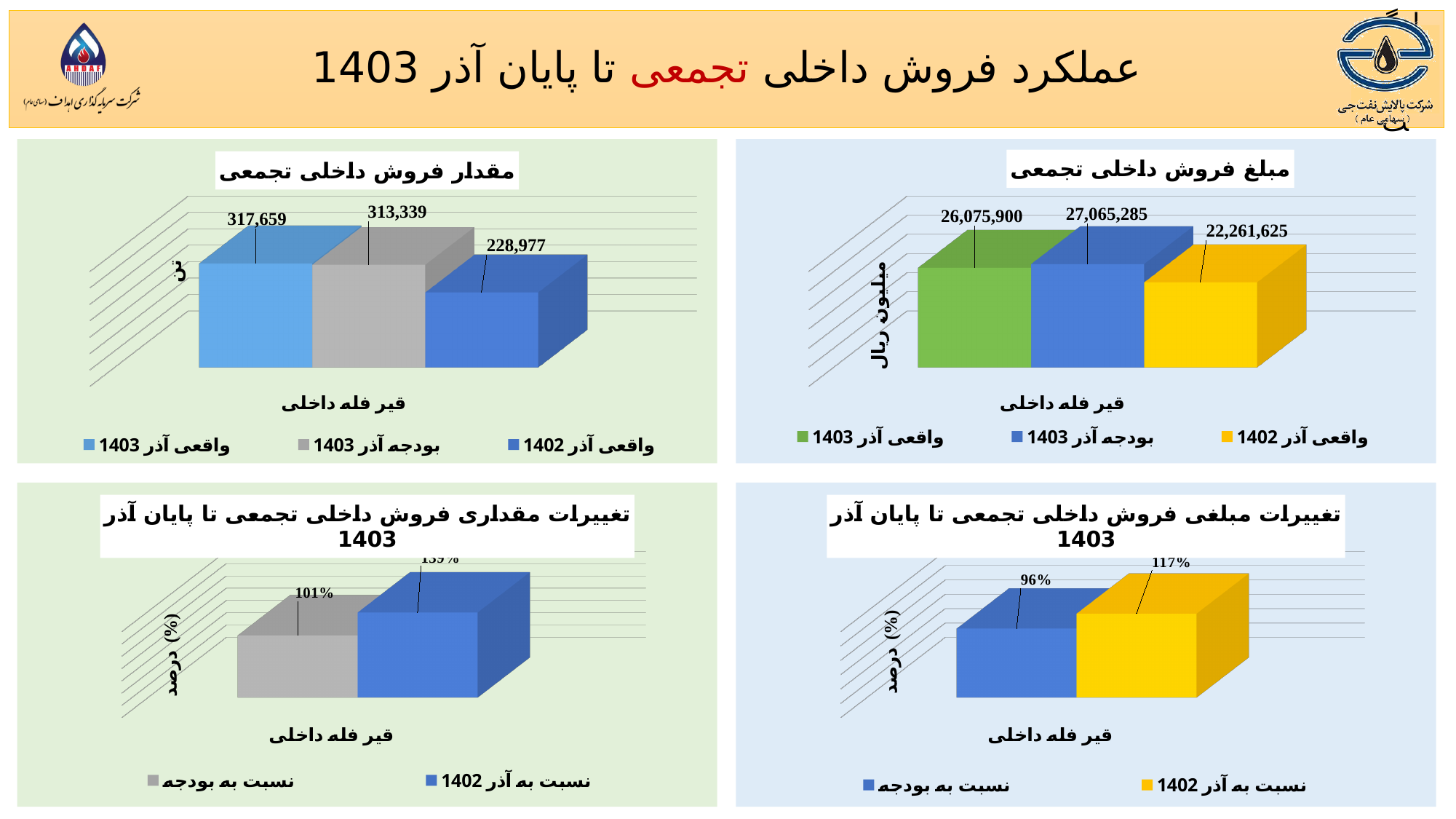
In the bottom-right chart (تغییرات مبلغی فروش داخلی تجمعی), what is the value for نسبت به آذر 1402? 117% In the bottom-left chart (تغییرات مقداری فروش داخلی تجمعی), what is the value for نسبت به بودجه? 101% In the bottom-right chart (تغییرات مبلغی فروش داخلی تجمعی), how many series does the legend list? 2 In the top-left chart (مقدار فروش داخلی تجمعی), what is the value for بودجه آذر 1403? 313,339 In the top-left chart (مقدار فروش داخلی تجمعی), what is the value for واقعی آذر 1403? 317,659 In the top-right chart (مبلغ فروش داخلی تجمعی), what is the value for بودجه آذر 1403? 27,065,285 In the top-left chart (مقدار فروش داخلی تجمعی), which series has the lowest value? واقعی آذر 1402 In the top-right chart (مبلغ فروش داخلی تجمعی), which series has the highest value? بودجه آذر 1403 In the top-right chart (مبلغ فروش داخلی تجمعی), what is the value for واقعی آذر 1402? 22,261,625 In the top-right chart (مبلغ فروش داخلی تجمعی), which is larger: واقعی آذر 1403 or بودجه آذر 1403? بودجه آذر 1403 In the top-left chart (مقدار فروش داخلی تجمعی), what is the difference between واقعی آذر 1403 and واقعی آذر 1402? 88,682 In the top-right chart (مبلغ فروش داخلی تجمعی), what unit is shown on the vertical axis? میلیون ریال